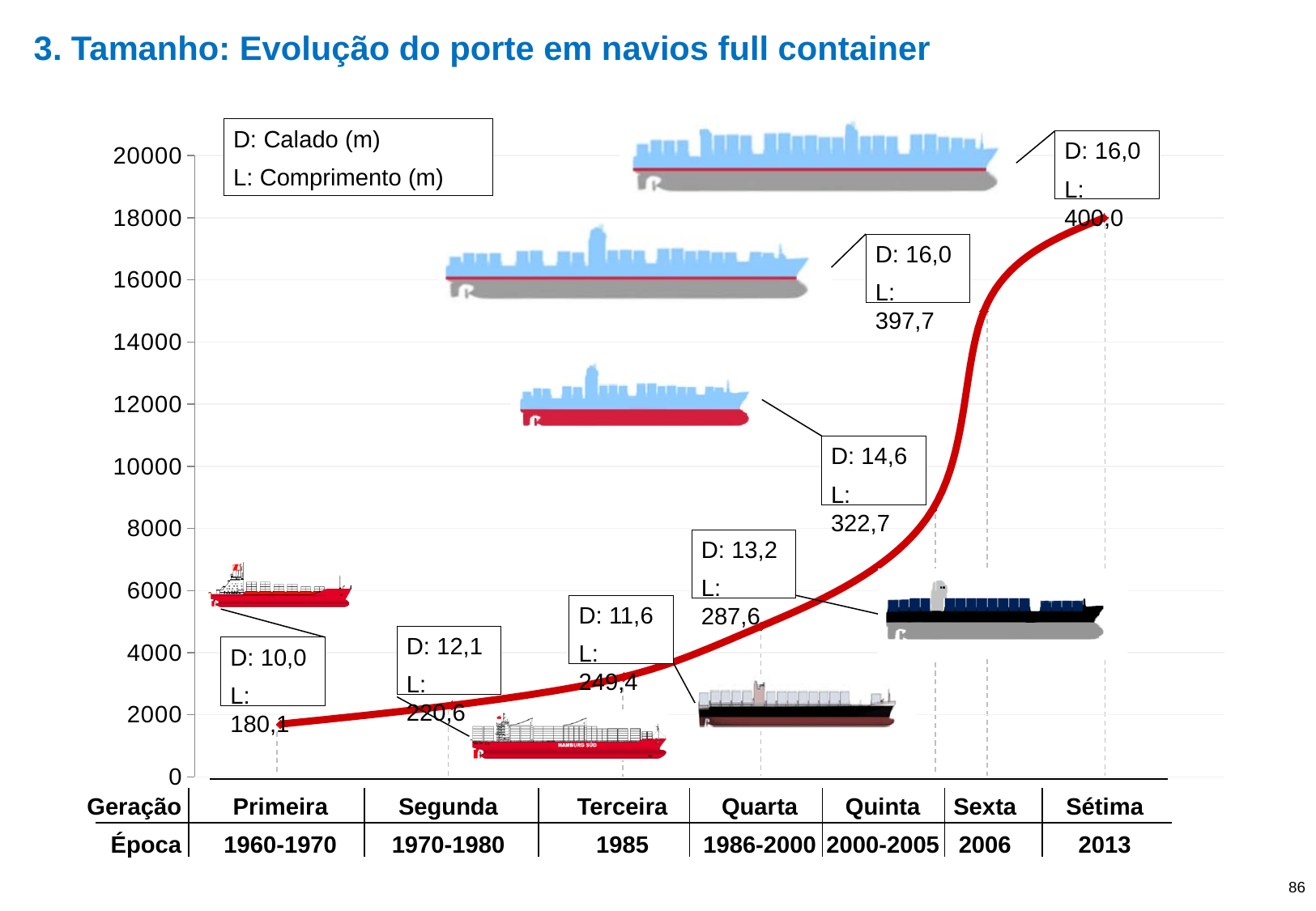
What kind of chart is shown on the slide? line chart What is the comprimento (L) given for the Quarta generation? 287,6 What Época is listed for the Terceira generation? 1985 Is the value of the curve at the Sétima generation greater or less than 16000? greater What is the calado (D) given for the Quinta generation? 14,6 Which generation has the larger comprimento (L), Quarta or Quinta? Quinta What is the comprimento (L) given for the Sétima generation? 400,0 How many generations (Geração) are shown along the x axis? 7 What is the calado (D) given for the Primeira generation? 10,0 Does the red curve rise or fall from the Primeira to the Sétima generation? rises What is the difference in comprimento (L) between the Sétima and Primeira generations? 219,9